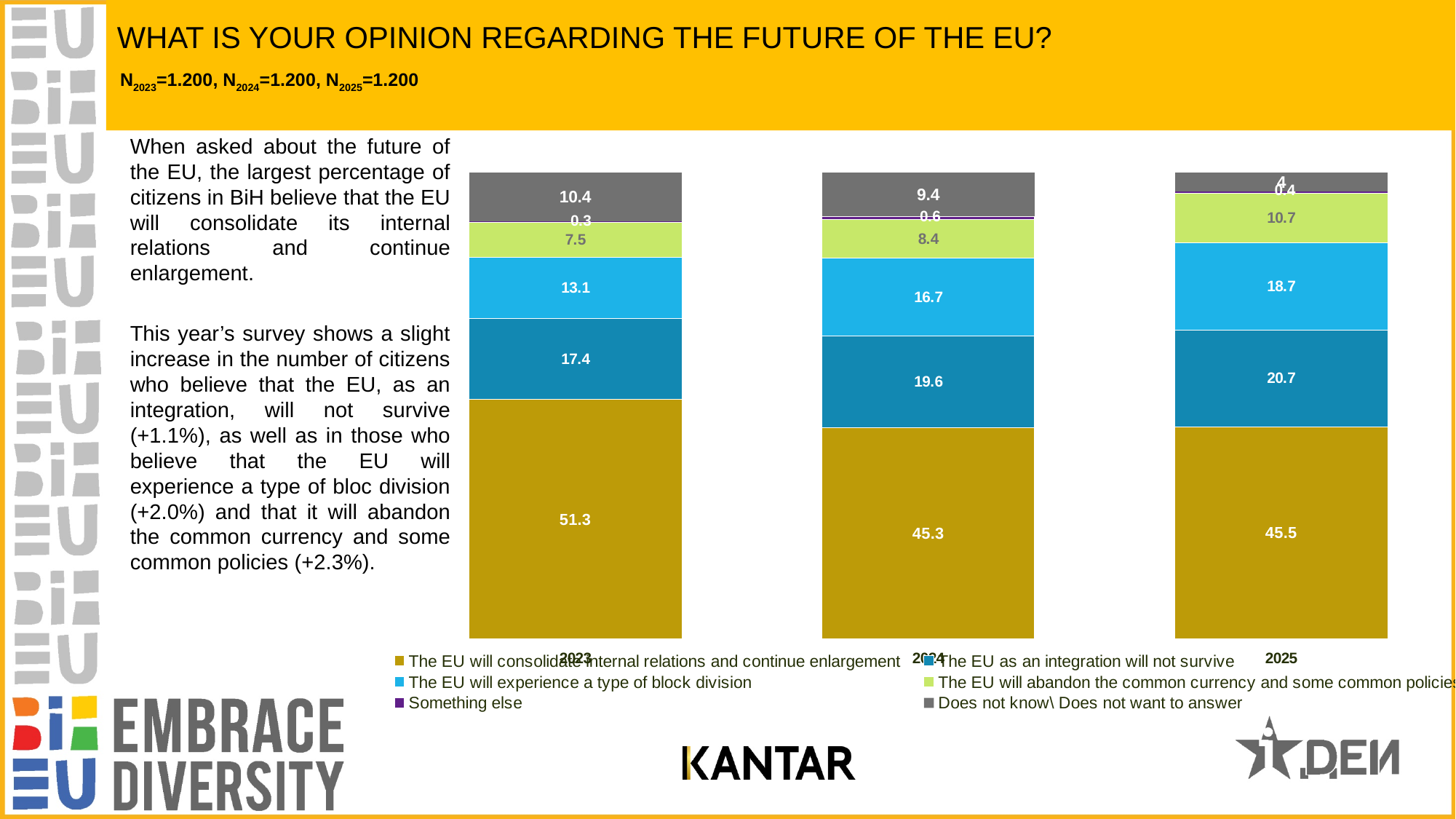
What is the value for 'The EU will abandon the common currency and some common policies' in 2025? 10.7 What is the value for 'The EU as an integration will not survive' in 2025? 20.7 What is the difference between the 2023 and 2024 values for 'The EU will consolidate internal relations and continue enlargement'? 6.0 Which year has the larger value for 'The EU will experience a type of block division', 2023 or 2025? 2025 What percentage of respondents in 2023 said the EU will consolidate internal relations and continue enlargement? 51.3 How many series does the legend list? 6 What is the value for 'The EU will experience a type of block division' in 2024? 16.7 How many years are shown on the x axis of the chart? 3 By how much did the value for 'The EU as an integration will not survive' change from 2024 to 2025? 1.1 What kind of chart is shown on the slide? Stacked bar chart In which year was the share saying the EU will consolidate internal relations and continue enlargement the highest? 2023 What is the value for 'Does not know\ Does not want to answer' in 2023? 10.4